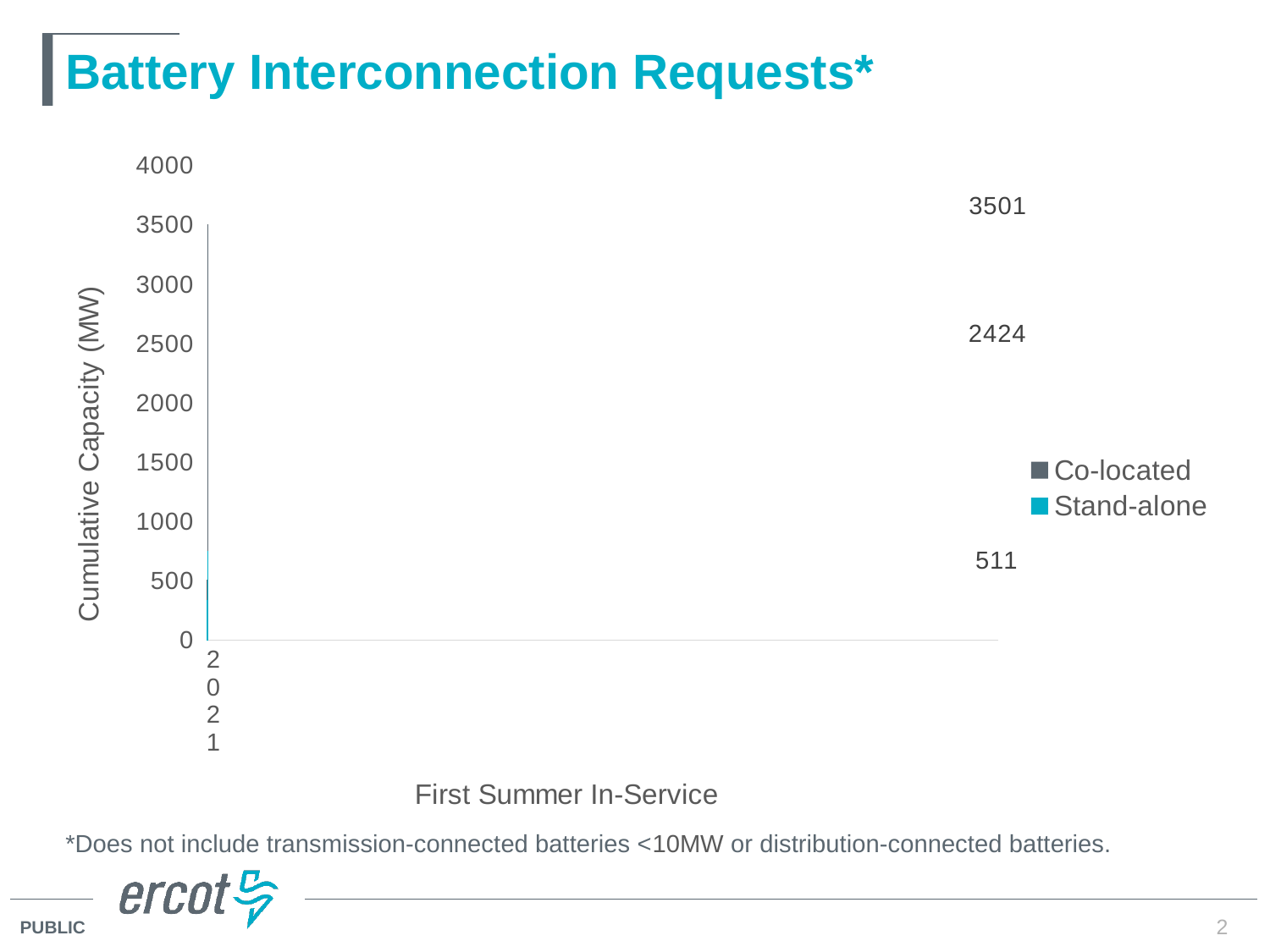
How many categories are labelled on the x axis? 1 What are the two series named in the legend? Co-located and Stand-alone How many series does the legend list? 2 What kind of chart is shown on the slide? bar chart What is the highest tick value shown on the vertical axis? 4000 What is the title of the vertical axis? Cumulative Capacity (MW)